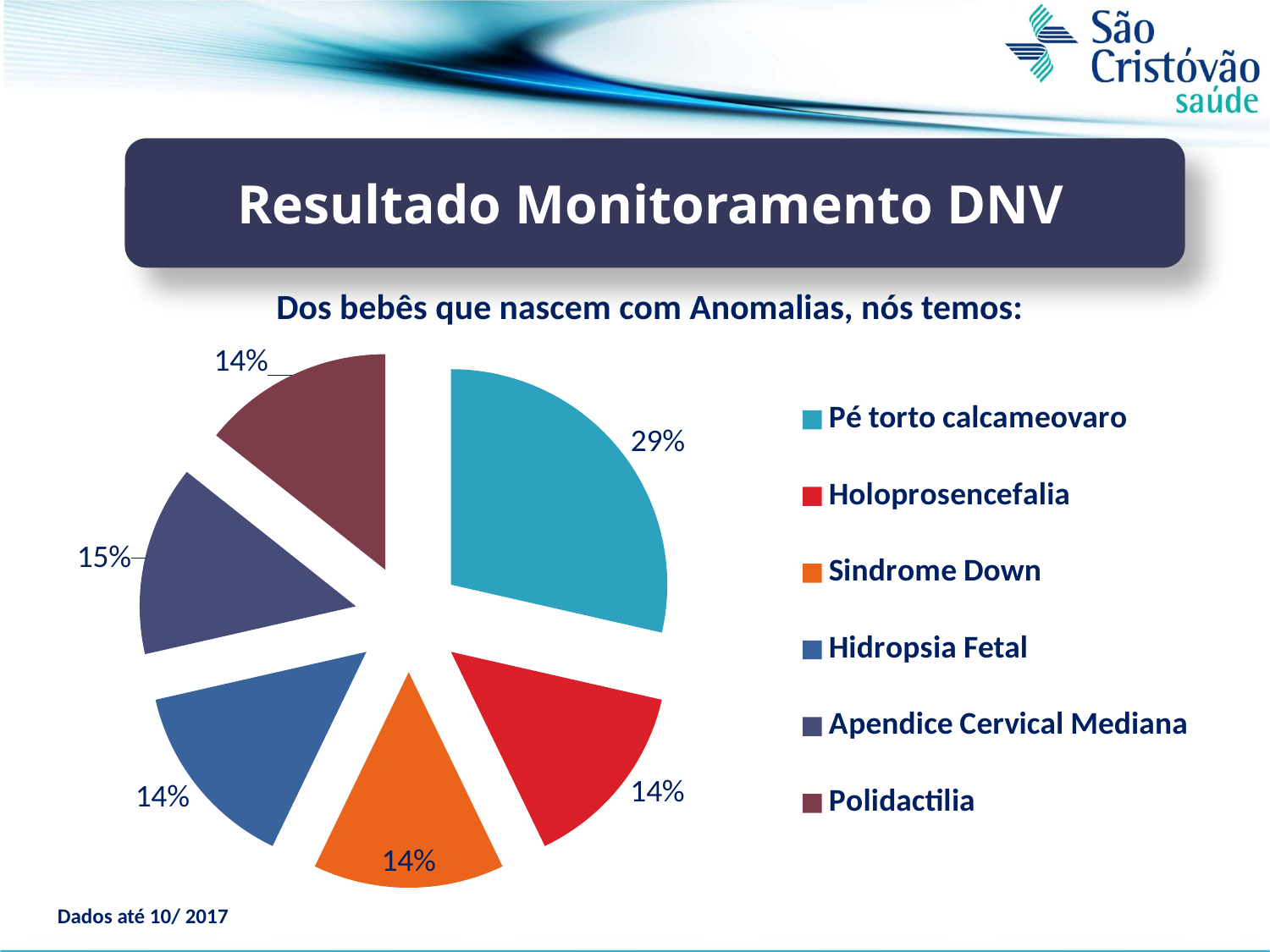
What is the title shown above the pie chart? Dos bebês que nascem com Anomalias, nós temos: Which is larger, the share for Pé torto calcameovaro or the share for Apendice Cervical Mediana? Pé torto calcameovaro What kind of chart is shown on the slide? Pie chart What is the difference in percentage points between Pé torto calcameovaro and Hidropsia Fetal? 15 What is the difference in percentage points between Pé torto calcameovaro and Apendice Cervical Mediana? 14 Which is larger, the share for Apendice Cervical Mediana or the share for Sindrome Down? Apendice Cervical Mediana What percentage is shown for Polidactilia? 14% What percentage is shown for Apendice Cervical Mediana? 15% Which category has the largest slice of the pie? Pé torto calcameovaro What percentage is shown for Holoprosencefalia? 14% What share of the pie does Pé torto calcameovaro represent? 29% How many slices does the pie chart have? 6